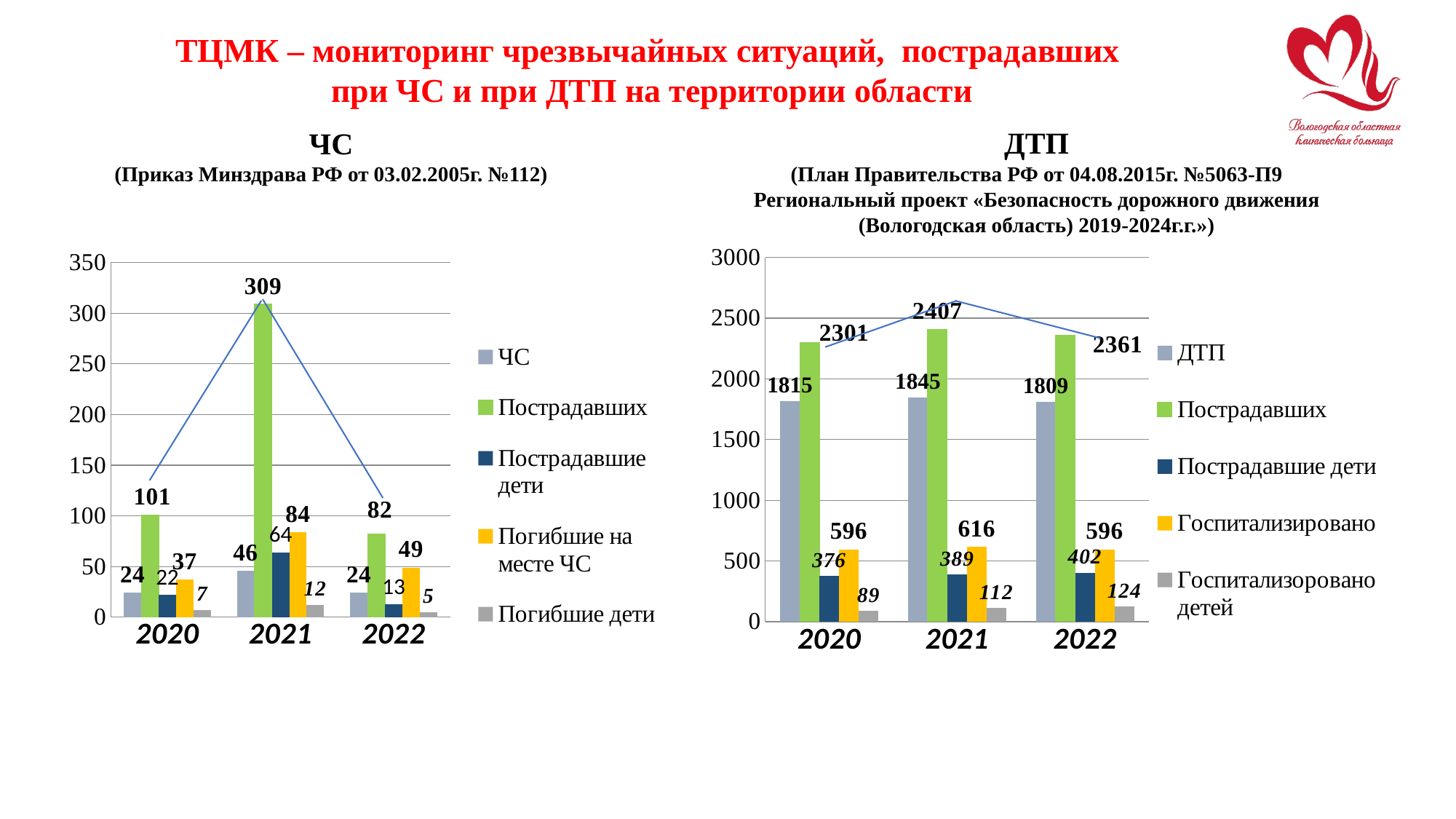
In the ДТП chart on the right, how many years are shown on the x axis? 3 In the ЧС chart on the left, what is the value for Пострадавших in 2021? 309 In the ДТП chart on the right, what is the value for ДТП in 2021? 1845 In the ЧС chart on the left, how many series does the legend list? 5 In the ДТП chart on the right, which is larger: Пострадавших in 2021 or Пострадавших in 2022? 2021 In the ЧС chart on the left, what is the value for Погибшие на месте ЧС in 2022? 49 In the ЧС chart on the left, is the Пострадавшие дети value for 2021 greater or less than 50? greater In the ЧС chart on the left, what is the difference between the Пострадавших values for 2021 and 2022? 227 In the ЧС chart on the left, in which year is the Пострадавших value highest? 2021 In the ДТП chart on the right, in which year is the Пострадавшие дети value lowest? 2020 What kind of chart is the ДТП chart on the right? bar chart In the ДТП chart on the right, what is the value for Госпитализировано детей in 2022? 124